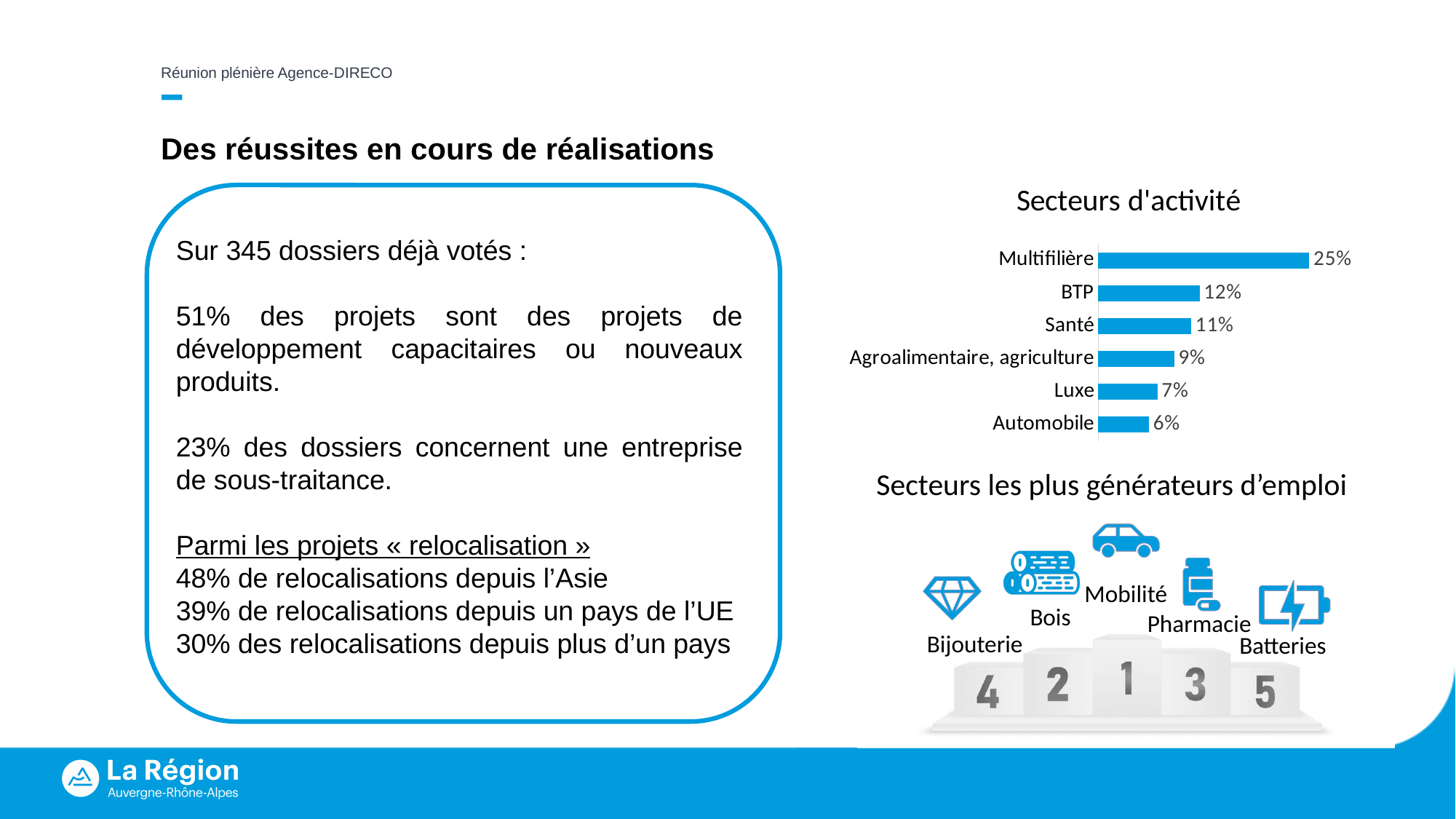
Which category has the highest value in the 'Secteurs d'activité' chart? Multifilière Which category has the lowest value in the 'Secteurs d'activité' chart? Automobile What is the value for BTP in the 'Secteurs d'activité' chart? 12% What is the value for Automobile in the 'Secteurs d'activité' chart? 6% What is the value for Agroalimentaire, agriculture in the 'Secteurs d'activité' chart? 9% What is the value for Multifilière in the 'Secteurs d'activité' chart? 25% Which is larger in the 'Secteurs d'activité' chart, Luxe or Automobile? Luxe What is the title of the bar chart on the slide? Secteurs d'activité What kind of chart is the 'Secteurs d'activité' chart? Bar chart What is the value for Santé in the 'Secteurs d'activité' chart? 11% What is the difference between Multifilière and BTP in the 'Secteurs d'activité' chart? 13% How many categories are shown in the 'Secteurs d'activité' chart? 6